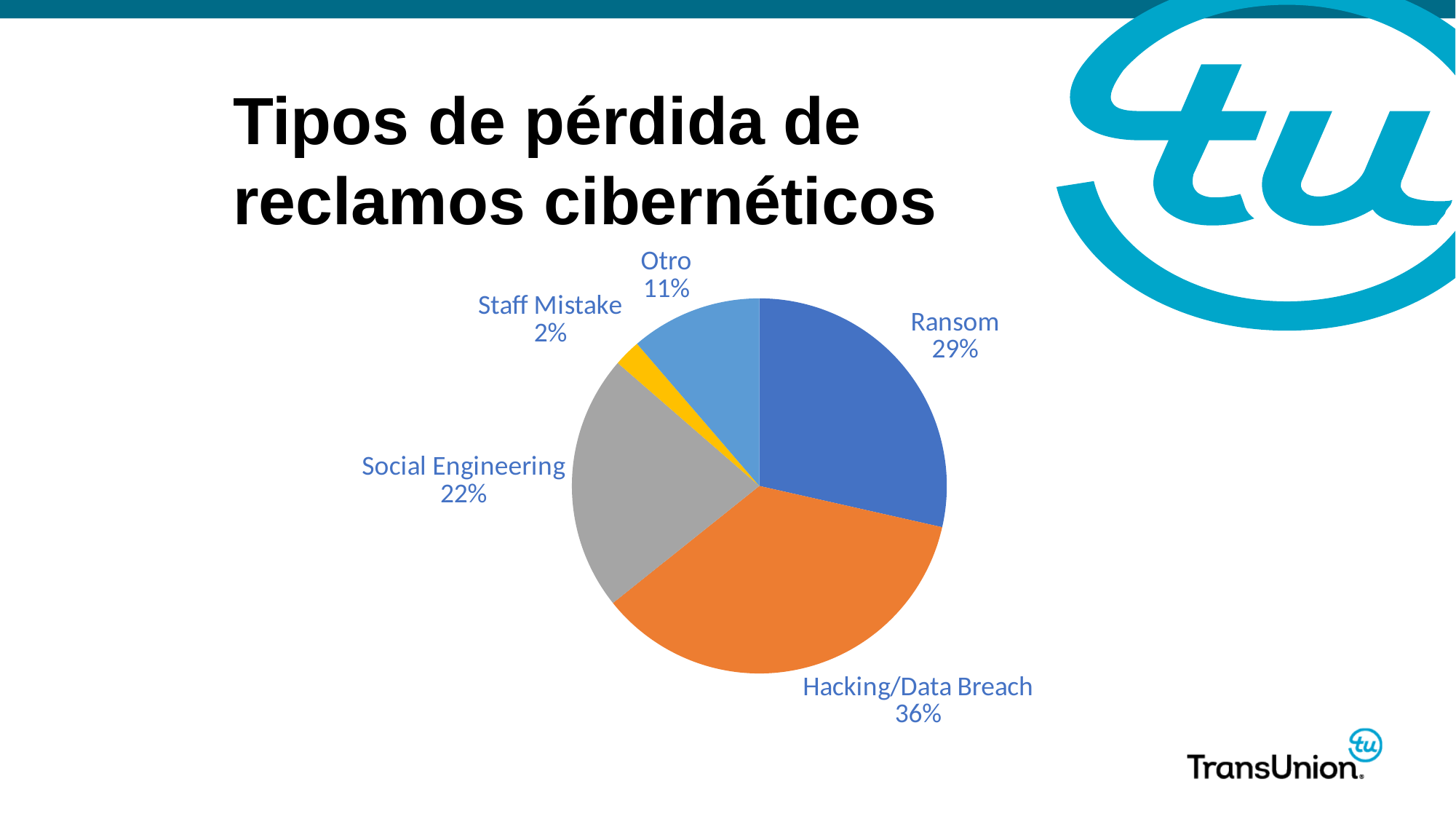
What percentage is shown for Otro? 11% What percentage is shown for Hacking/Data Breach? 36% Which is larger, the share for Social Engineering or the share for Otro? Social Engineering What type of chart is shown on the slide? Pie chart What is the difference in percentage points between Hacking/Data Breach and Ransom? 7 Which category has the largest share of the pie? Hacking/Data Breach Which category has the smallest share of the pie? Staff Mistake How many categories are shown in the pie chart? 5 What percentage is shown for Social Engineering? 22% What share of cyber claim losses is attributed to Ransom? 29% What is the title of the slide containing the pie chart? Tipos de pérdida de reclamos cibernéticos What percentage is shown for Staff Mistake? 2%